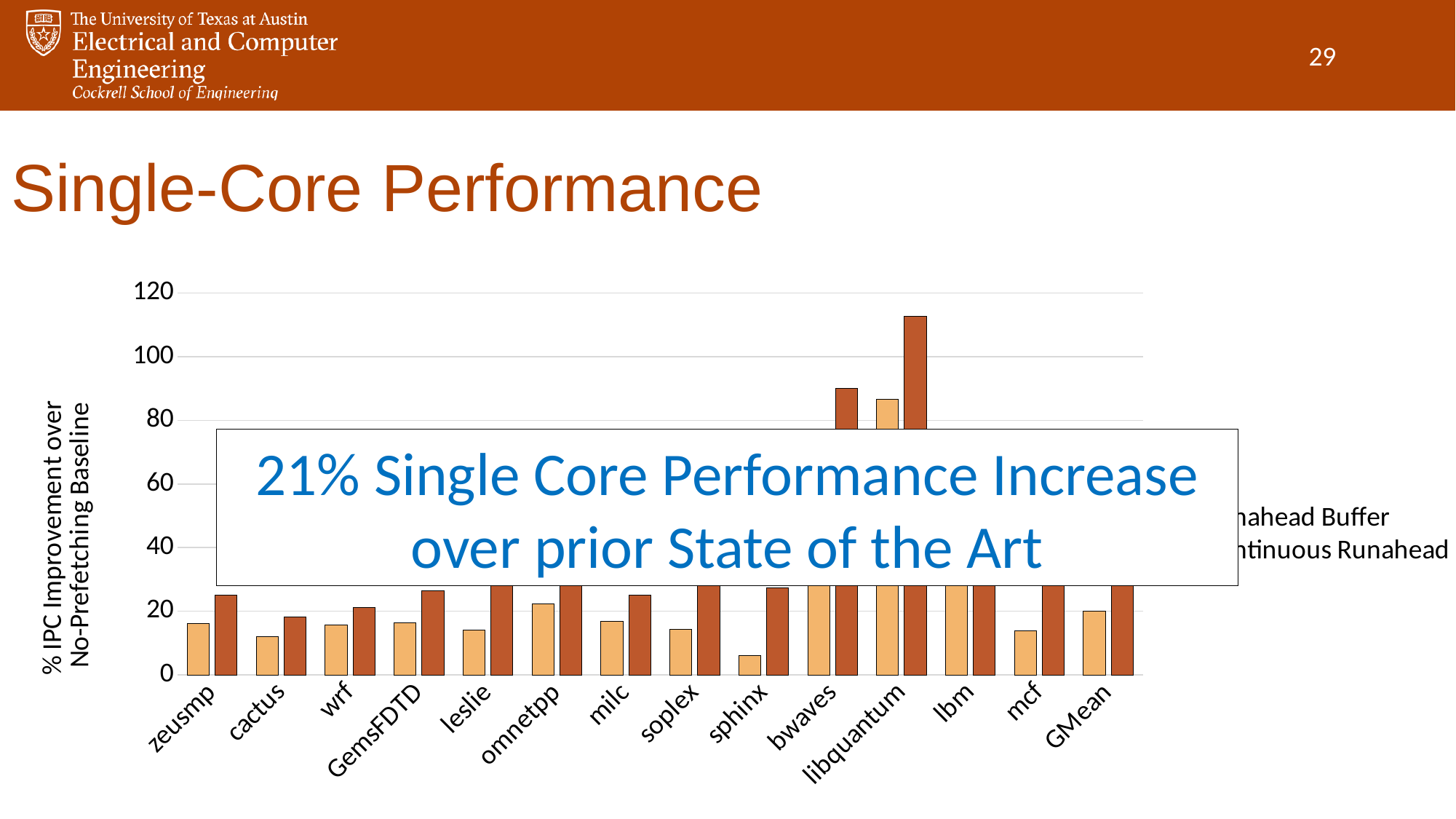
Is the light orange bar for cactus greater or less than 20? less For sphinx, which bar is larger, the light orange one or the dark brown one? the dark brown one Is the light orange bar for sphinx greater or less than 20? less Which category has the lowest light orange bar? sphinx Is the dark brown bar for libquantum greater or less than 100? greater Which category has the highest dark brown bar? libquantum How many benchmark categories are shown along the x axis of the chart? 14 How many data series does the chart plot? 2 Which light orange bar is larger, zeusmp or cactus? zeusmp What is the label on the y axis of the chart? % IPC Improvement over No-Prefetching Baseline What kind of chart is shown on the slide? bar chart